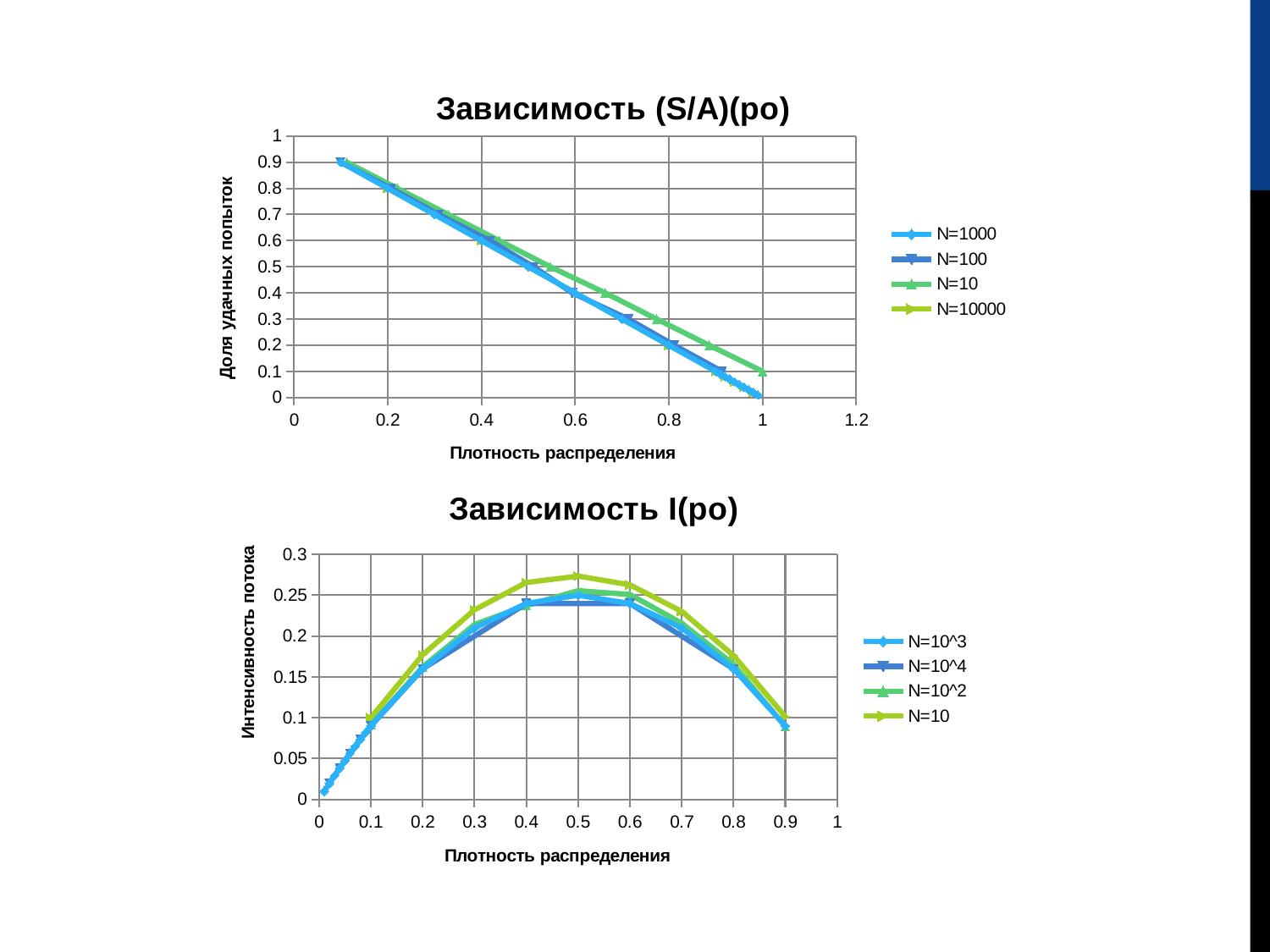
What is the x-axis label of the bottom chart "Зависимость I(ро)"? Плотность распределения In the top chart "Зависимость (S/A)(ро)", is the value for N=10 at x = 0.9 greater or less than 0.3? less What type of chart is the bottom chart titled "Зависимость I(ро)"? line chart How many series does the legend of the bottom chart "Зависимость I(ро)" list? 4 In the top chart "Зависимость (S/A)(ро)", do the values rise or fall as the x axis increases? fall In the top chart "Зависимость (S/A)(ро)", is the value for N=1000 at x = 0.3 greater or less than 0.5? greater In the bottom chart "Зависимость I(ро)", is the value for N=10^3 at x = 0.9 greater or less than 0.1? less What type of chart is the top chart titled "Зависимость (S/A)(ро)"? line chart In the bottom chart "Зависимость I(ро)", which series has the highest value at x = 0.5? N=10 What is the y-axis label of the top chart "Зависимость (S/A)(ро)"? Доля удачных попыток How many series does the legend of the top chart "Зависимость (S/A)(ро)" list? 4